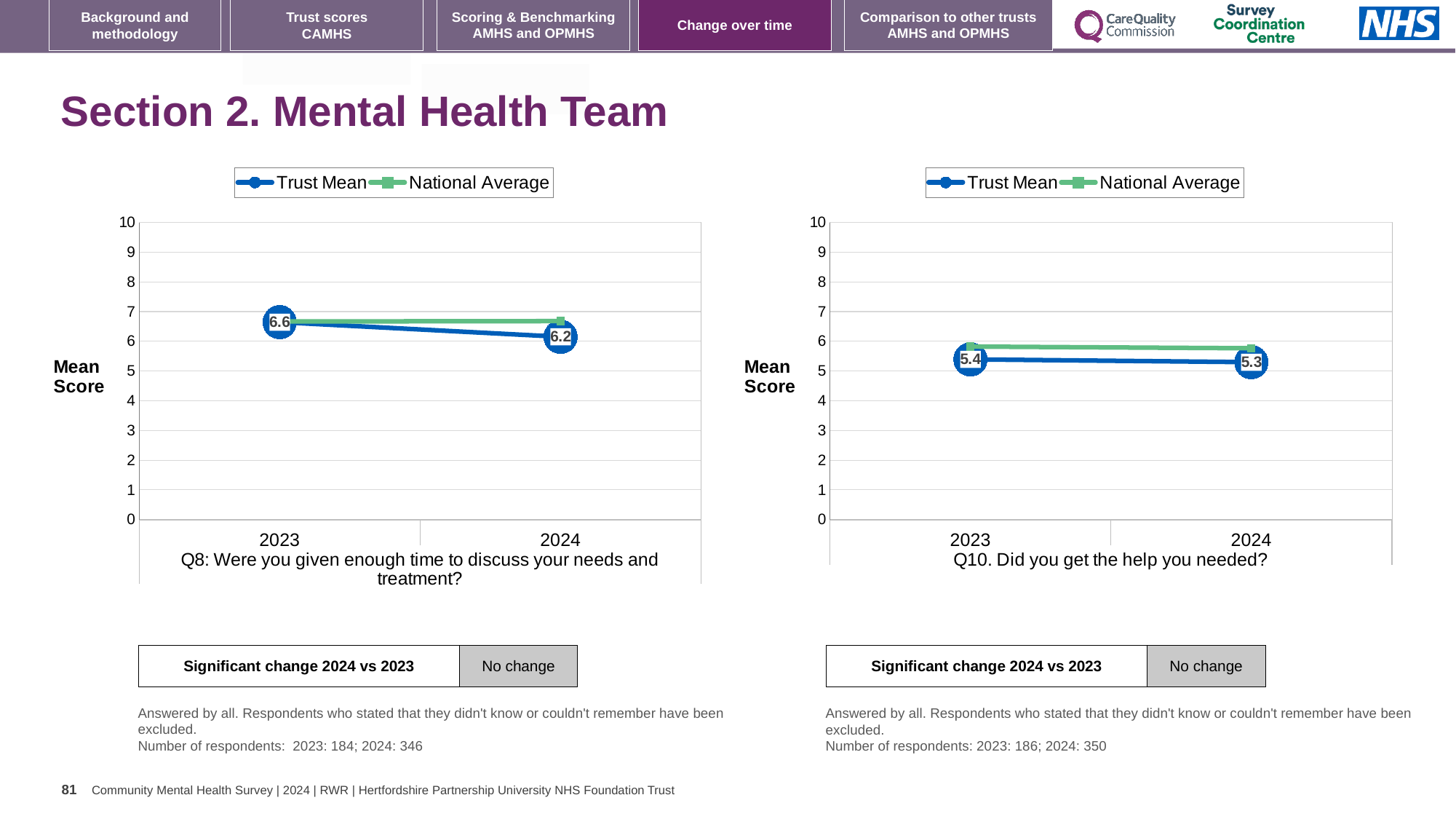
In the left chart (Q8), by how much did the Trust Mean change from 2023 to 2024? 0.4 What kind of chart is the left chart (Q8)? line chart In the right chart (Q10), what is the Trust Mean for 2024? 5.3 In the left chart (Q8), does the Trust Mean rise or fall from 2023 to 2024? fall In the left chart (Q8: Were you given enough time to discuss your needs and treatment?), what is the Trust Mean for 2023? 6.6 In the left chart (Q8), what is the Trust Mean for 2024? 6.2 How many series does the legend of the right chart (Q10) list? 2 In the left chart (Q8), is the National Average for 2024 greater or less than 7? less How many years are plotted on the x axis of the left chart (Q8)? 2 In the right chart (Q10. Did you get the help you needed?), what is the Trust Mean for 2023? 5.4 In the right chart (Q10), is the National Average for 2024 greater or less than 5? greater In the right chart (Q10), which year has the higher Trust Mean, 2023 or 2024? 2023